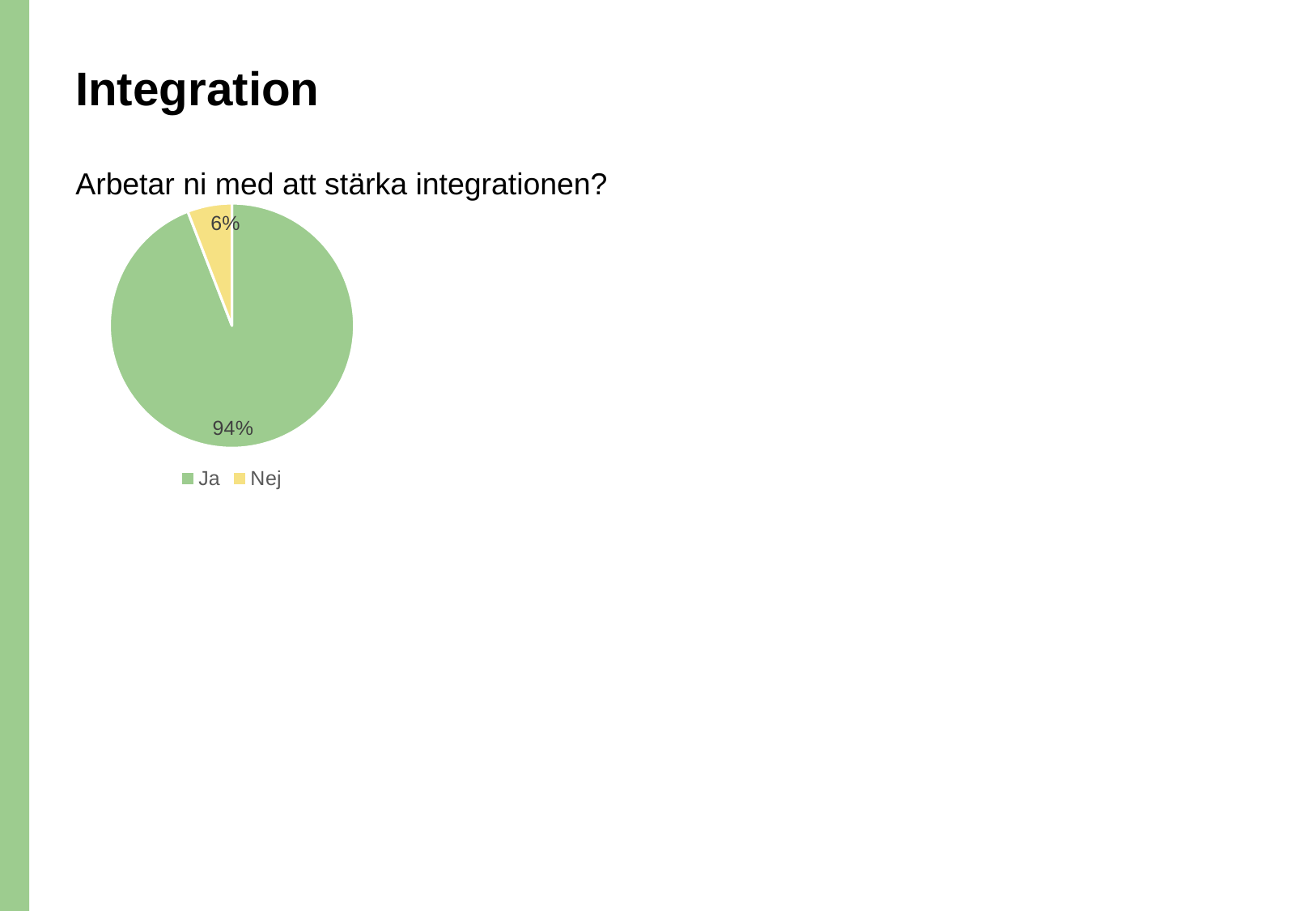
What is the difference in percentage points between the "Ja" and "Nej" slices? 88 What share of the pie does the "Nej" slice represent? 6% What colour is the "Nej" slice in the pie chart? Yellow How many slices does the pie chart have? 2 Which category has the largest slice of the pie? Ja What share of the pie does the "Ja" slice represent? 94% What kind of chart is shown on the slide? Pie chart Which is larger, the "Ja" slice or the "Nej" slice? Ja What question is the pie chart answering, as written above it? Arbetar ni med att stärka integrationen? Which category has the smallest slice of the pie? Nej How many entries does the legend list? 2